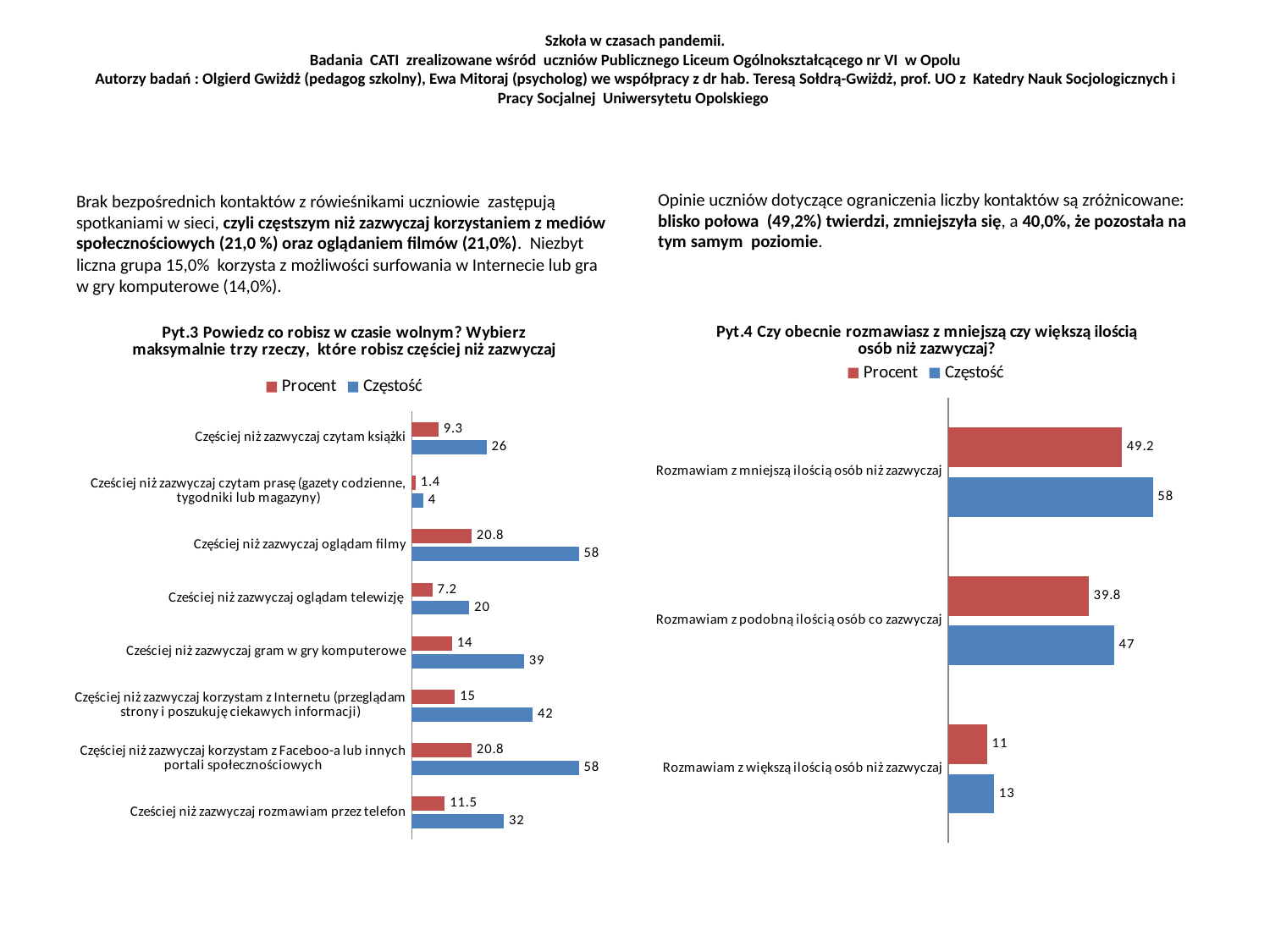
In the Pyt.4 chart, what is the Procent value for 'Rozmawiam z podobną ilością osób co zazwyczaj'? 39.8 In the Pyt.4 chart, what is the difference between the Częstość values for 'Rozmawiam z mniejszą ilością osób niż zazwyczaj' and 'Rozmawiam z większą ilością osób niż zazwyczaj'? 45 How many series does the legend of the Pyt.3 chart list? 2 In the Pyt.3 chart, what is the Procent value for 'Częściej niż zazwyczaj oglądam filmy'? 20.8 In the Pyt.4 chart, which colour represents the Procent series? Red How many categories are shown in the Pyt.3 chart? 8 In the Pyt.4 chart, which category has the highest Częstość value? Rozmawiam z mniejszą ilością osób niż zazwyczaj In the Pyt.3 chart, what is the difference between the Częstość values for 'Częściej niż zazwyczaj korzystam z Internetu' and 'Częściej niż zazwyczaj rozmawiam przez telefon'? 10 What type of chart is the Pyt.4 chart? Bar chart In the Pyt.3 chart, which category has the lowest Częstość value? Częściej niż zazwyczaj czytam prasę (gazety codzienne, tygodniki lub magazyny) In the Pyt.3 chart, which has a larger Procent value: 'Częściej niż zazwyczaj czytam książki' or 'Częściej niż zazwyczaj oglądam telewizję'? Częściej niż zazwyczaj czytam książki In the Pyt.3 chart, what is the Częstość value for 'Częściej niż zazwyczaj gram w gry komputerowe'? 39